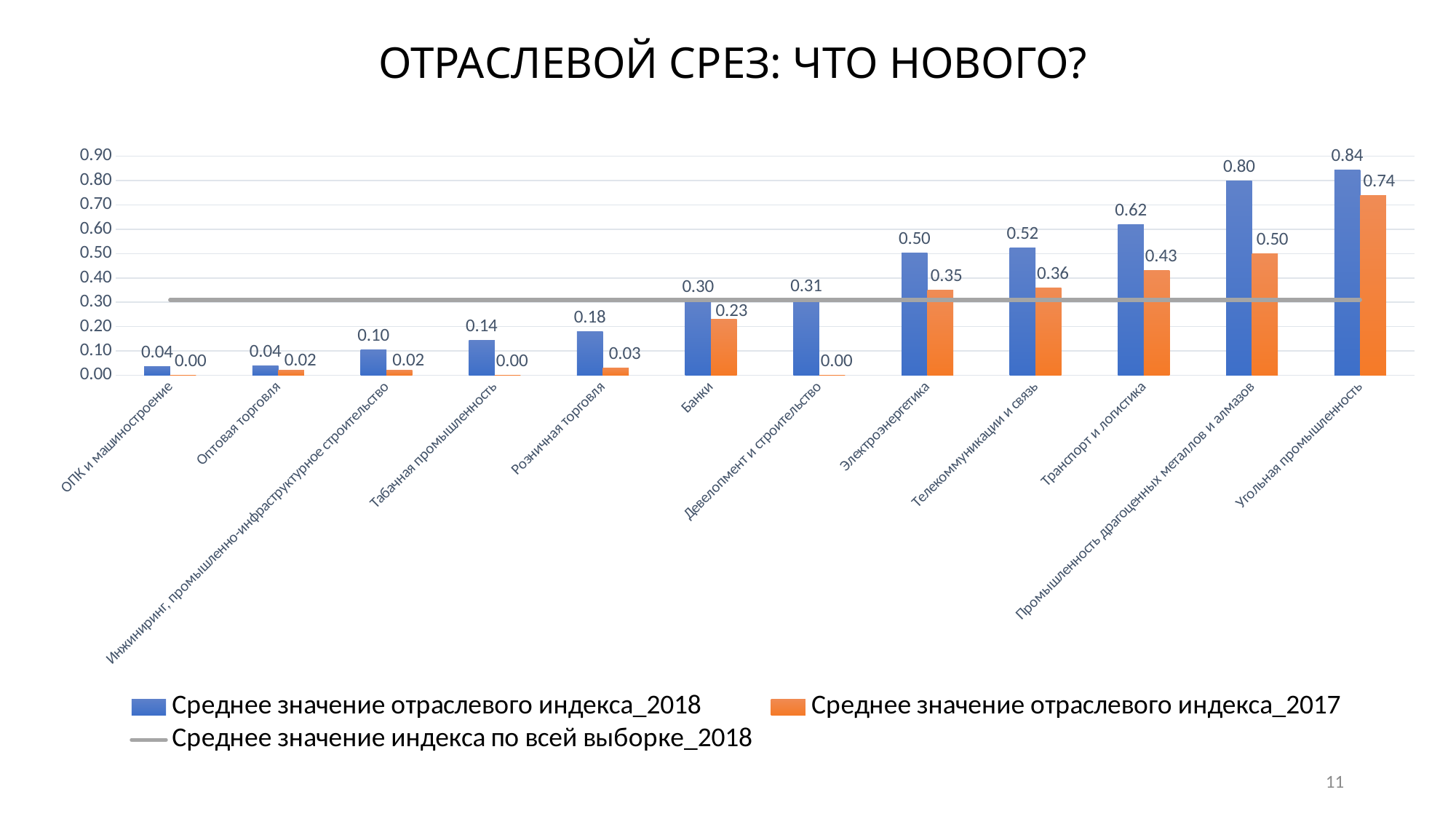
How many categories are shown on the x axis? 12 What is the value of Среднее значение отраслевого индекса_2018 for Угольная промышленность? 0.84 What is the value of Среднее значение отраслевого индекса_2017 for Транспорт и логистика? 0.43 Which is larger: the 2018 value for Электроэнергетика or the 2018 value for Телекоммуникации и связь? Телекоммуникации и связь Which category has the highest value of Среднее значение отраслевого индекса_2017? Угольная промышленность What is the difference between the 2018 and 2017 values for Промышленность драгоценных металлов и алмазов? 0.30 What kind of chart is shown on the slide? Bar chart with a line Do the values of Среднее значение отраслевого индекса_2018 generally rise or fall from left to right along the x axis? Rise How many series does the legend list? 3 What is the value of Среднее значение отраслевого индекса_2018 for Банки? 0.30 Which category has the lowest value of Среднее значение отраслевого индекса_2018? ОПК и машиностроение and Оптовая торговля (both 0.04) What colour are the bars for Среднее значение отраслевого индекса_2017? Orange